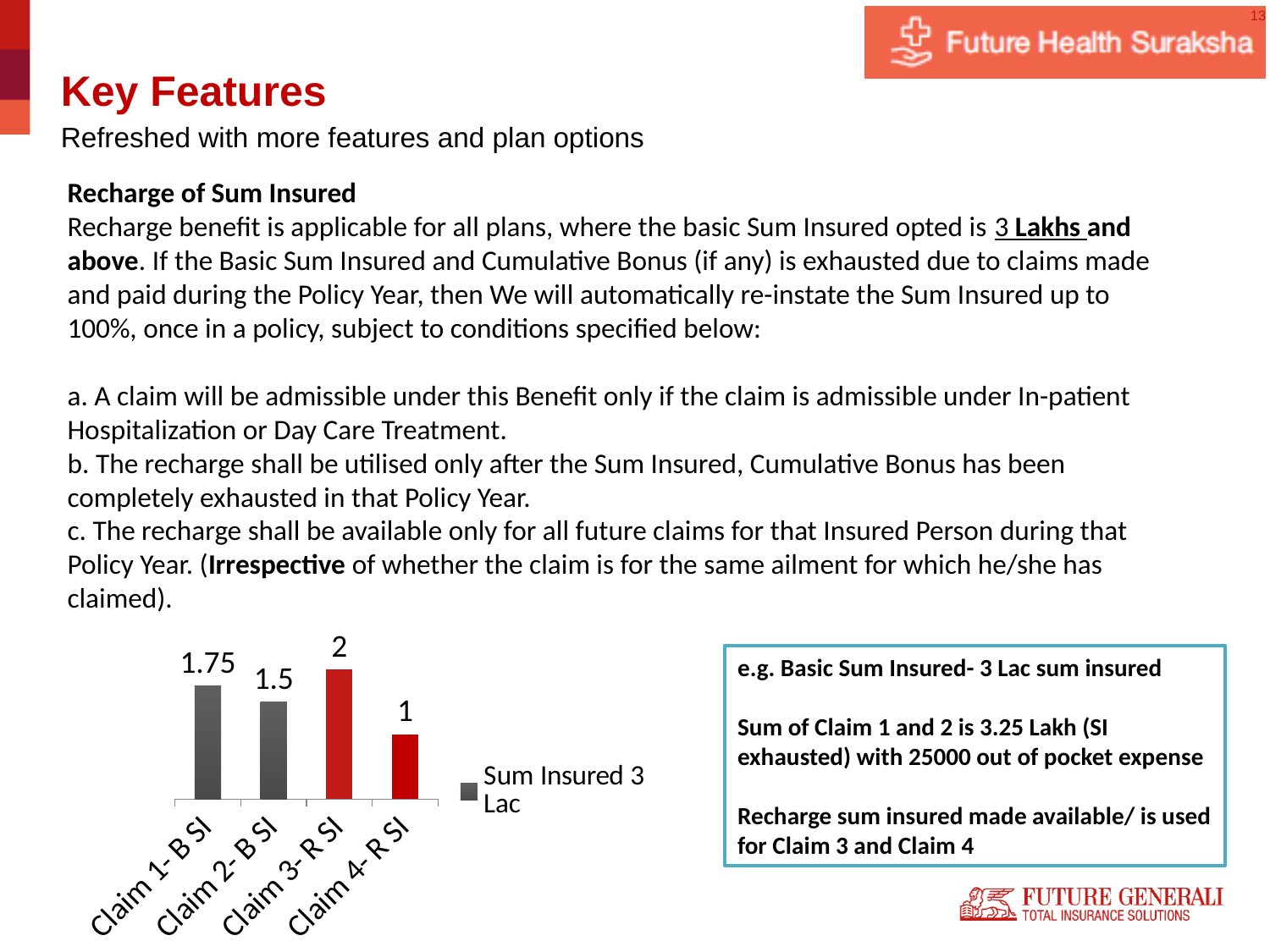
Which is larger, the value for Claim 2- B SI or the value for Claim 4- R SI? Claim 2- B SI How many series does the chart legend list? 1 What is the value for Claim 1- B SI? 1.75 What kind of chart is shown on the slide? Bar chart How many categories are shown on the x axis of the chart? 4 What is the value for Claim 3- R SI? 2 Which category has the lowest value? Claim 4- R SI What is the difference between the values for Claim 1- B SI and Claim 2- B SI? 0.25 What is the value for Claim 4- R SI? 1 Which category has the highest value? Claim 3- R SI What is the difference between the values for Claim 3- R SI and Claim 4- R SI? 1 What is the value for Claim 2- B SI? 1.5